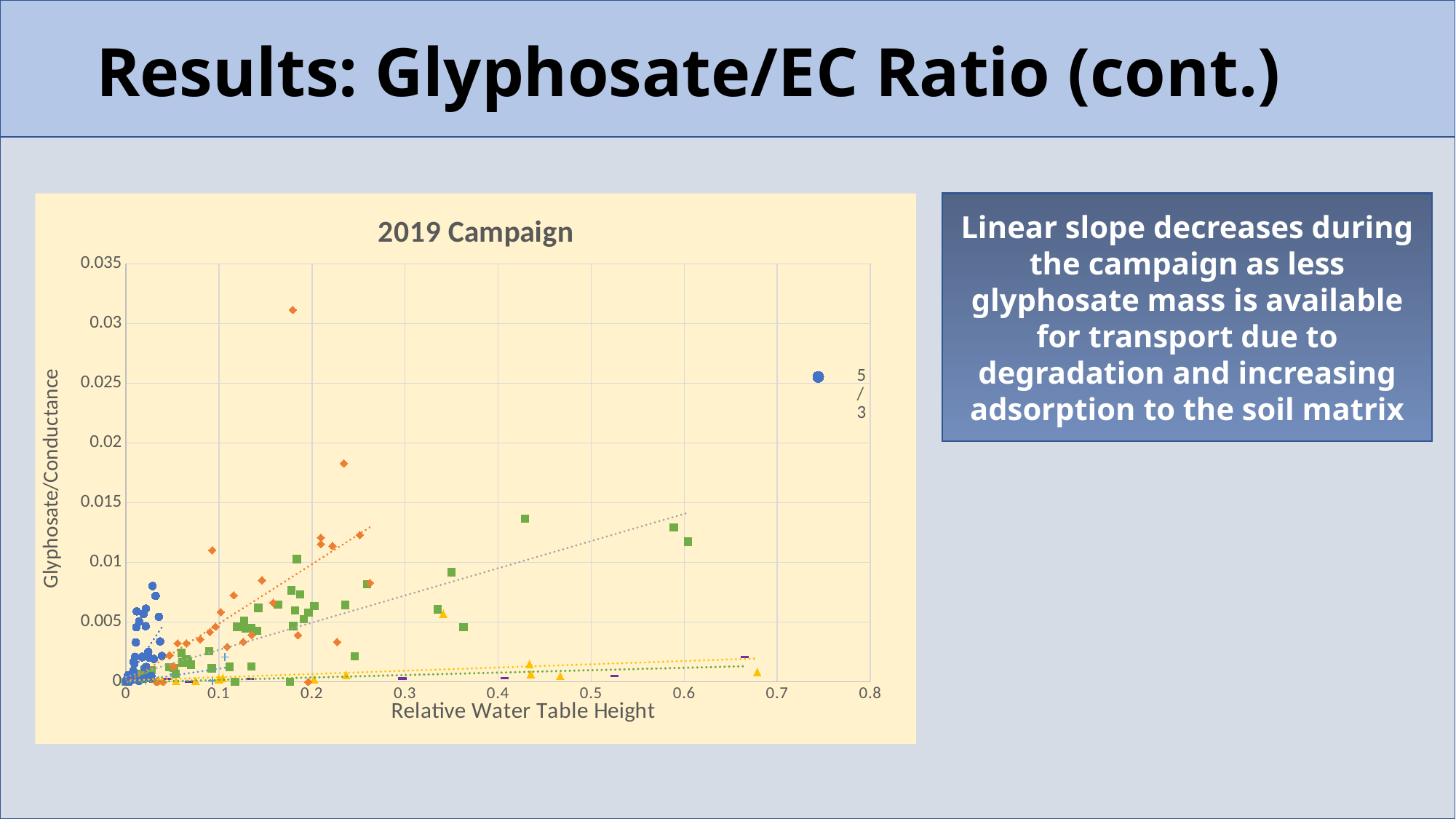
Which series has the point with the highest Glyphosate/Conductance value: the orange diamonds or the yellow triangles? Orange diamonds What is the highest value shown on the y axis of the chart? 0.035 What kind of chart is shown on the slide? Scatter chart Does the dotted trend line for the orange diamond series rise or fall as Relative Water Table Height increases? Rises Is the green square point near x = 0.43 greater or less than 0.01 on the y axis? greater What is the label of the x axis of the chart? Relative Water Table Height What is the title of the chart? 2019 Campaign Is the orange diamond point near x = 0.23 greater or less than 0.015 on the y axis? greater Is the highest orange diamond point on the chart greater or less than 0.025 on the y axis? greater What is the highest value shown on the x axis of the chart? 0.8